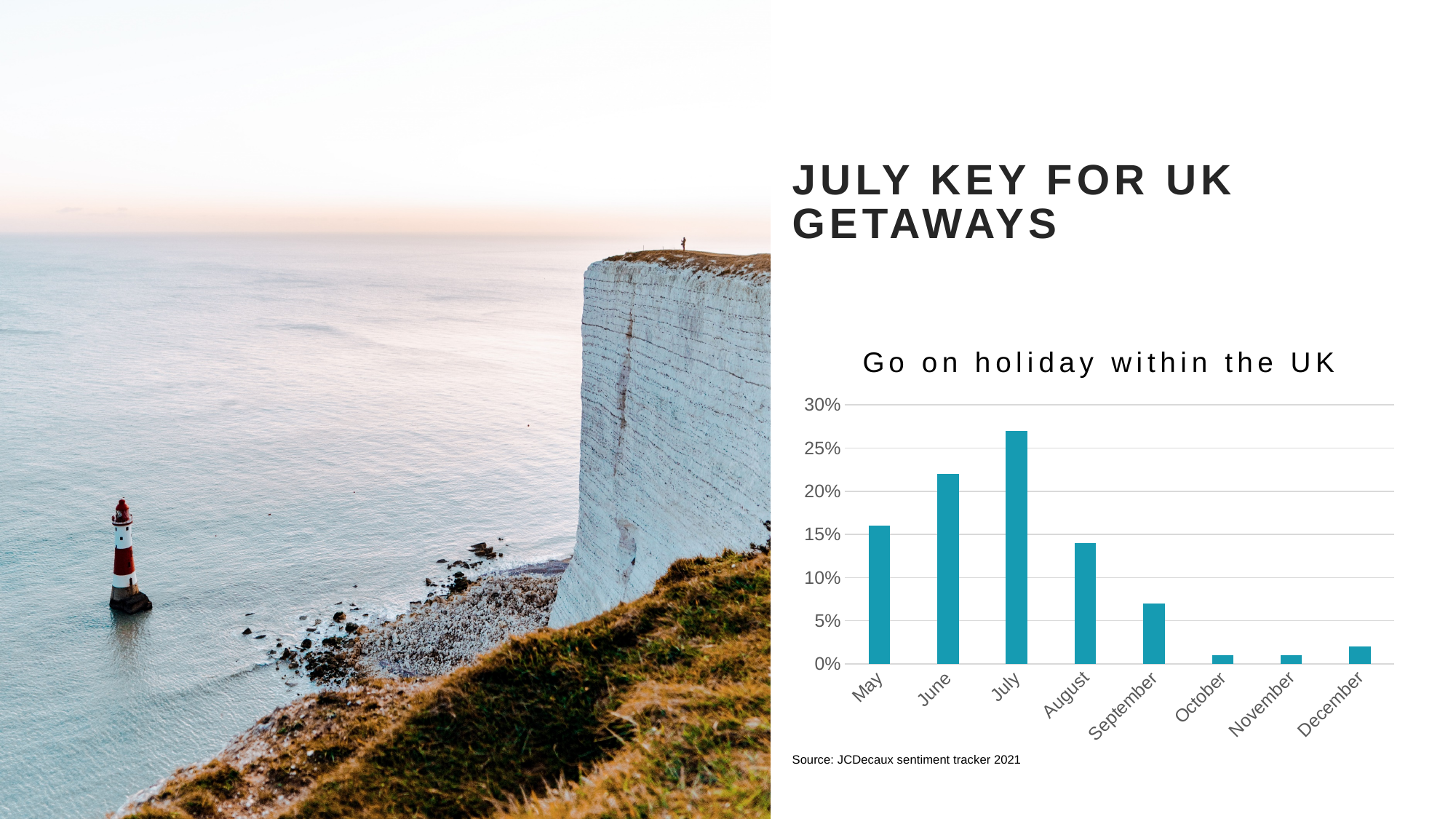
Which is larger, the value for June or the value for August? June Is the value for June greater or less than 20%? greater Is the value for May greater or less than 20%? less Is the value for December greater or less than 5%? less What kind of chart is shown on the slide? bar chart What is the title of the chart? Go on holiday within the UK Do the values rise or fall from July to October? fall Which month has the highest value in the chart? July How many months are shown on the x axis of the chart? 8